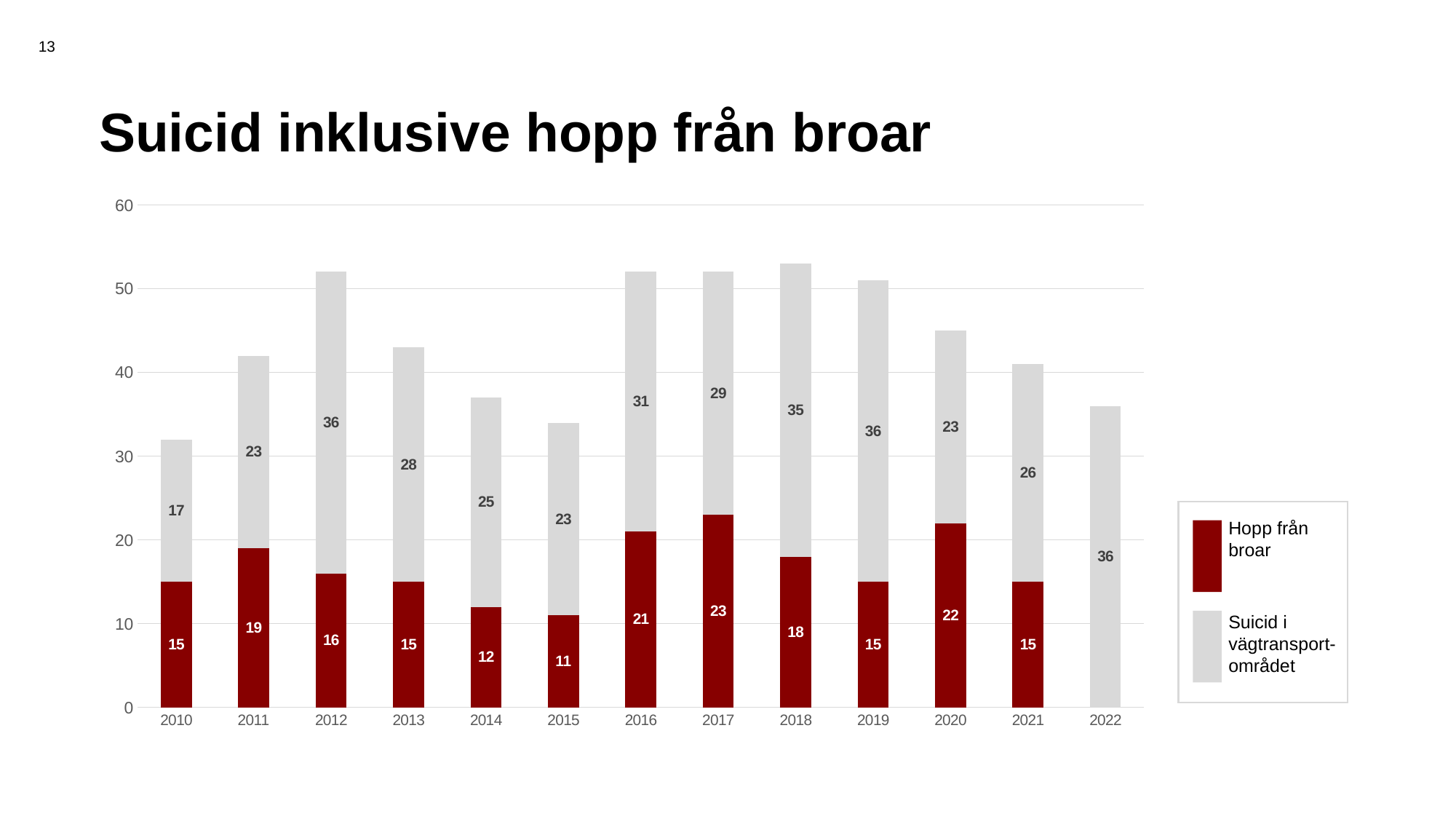
What is the difference between the Hopp från broar values for 2020 and 2014? 10 What is the total of the stacked bar for 2012? 52 How many series does the legend list? 2 What is the value for Suicid i vägtransport-området in 2014? 25 Which year has the lowest value for Suicid i vägtransport-området? 2010 What is the value for Hopp från broar in 2017? 23 Which is larger, the Suicid i vägtransport-området value for 2018 or for 2021? 2018 What is the value for Suicid i vägtransport-området in 2022? 36 How many years are shown on the x axis? 13 Which year has the lowest value for Hopp från broar? 2015 What kind of chart is shown on the slide? Stacked bar chart Which year has the highest value for Hopp från broar? 2017